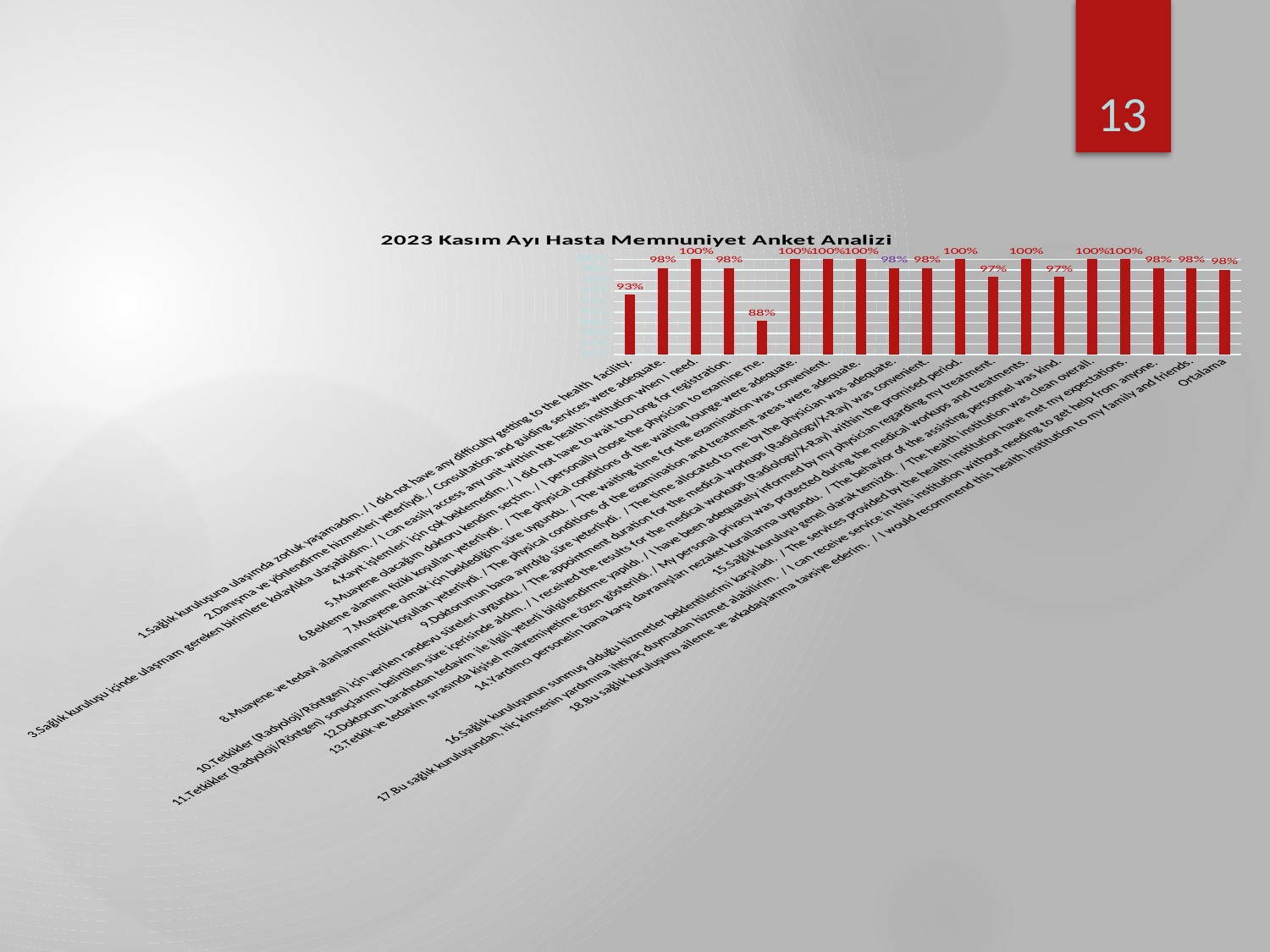
What type of chart is shown on the slide? bar chart What is the title of the chart? 2023 Kasım Ayı Hasta Memnuniyet Anket Analizi What is the value for item 12 ('12.Doktorum tarafından tedavim ile ilgili yeterli bilgilendirme yapıldı')? 97% What is the value for item 14 ('14.Yardımcı personelin bana karşı davranışları nezaket kurallarına uygundu')? 97% What is the value for item 5 ('5.Muayene olacağım doktoru kendim seçtim')? 88% What is the value for the category 'Ortalama'? 98% What is the value for item 1 ('1.Sağlık kuruluşuna ulaşımda zorluk yaşamadım')? 93% What is the difference between the value for item 1 (93%) and the value for item 5 (88%)? 5% What is the value for item 3 ('3.Sağlık kuruluşu içinde ulaşmam gereken birimlere kolaylıkla ulaşabildim')? 100% How many bars are plotted in the chart? 19 Which category has the lowest value in the chart? 5.Muayene olacağım doktoru kendim seçtim Which is larger: the value for item 1 ('1.Sağlık kuruluşuna ulaşımda zorluk yaşamadım') or the value for item 2 ('2.Danışma ve yönlendirme hizmetleri yeterliydi')? item 2